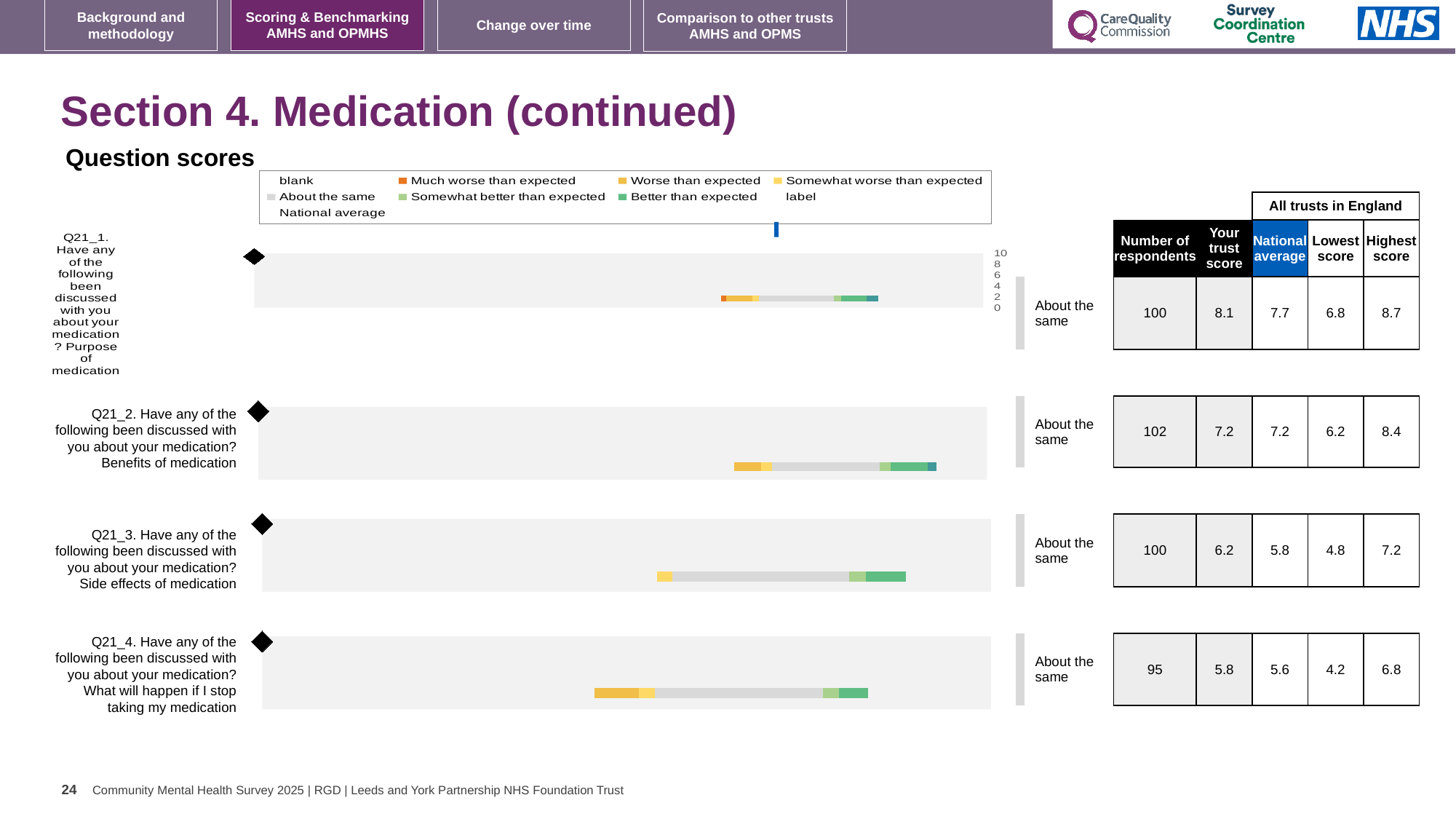
How many questions (Q21_1 to Q21_4) are charted on this slide? 4 Which question has the highest 'Your trust score' on this slide? Q21_1 (Purpose of medication) What benchmark label is shown next to the chart for Q21_2 (Benefits of medication)? About the same What is the highest score across all trusts in England for Q21_1 (Purpose of medication)? 8.7 What colour does the legend use for 'Much worse than expected'? orange What kind of chart is used to show the question scores on this slide? bar chart What is the national average for Q21_3 (Side effects of medication)? 5.8 For Q21_3 (Side effects of medication), which is larger: the trust score or the national average? the trust score Which question has the lowest 'Your trust score' on this slide? Q21_4 (What will happen if I stop taking my medication) What is the difference between the trust score and the national average for Q21_1 (Purpose of medication)? 0.4 How many respondents answered Q21_4 (What will happen if I stop taking my medication)? 95 What is the 'Your trust score' for Q21_2 (Benefits of medication)? 7.2